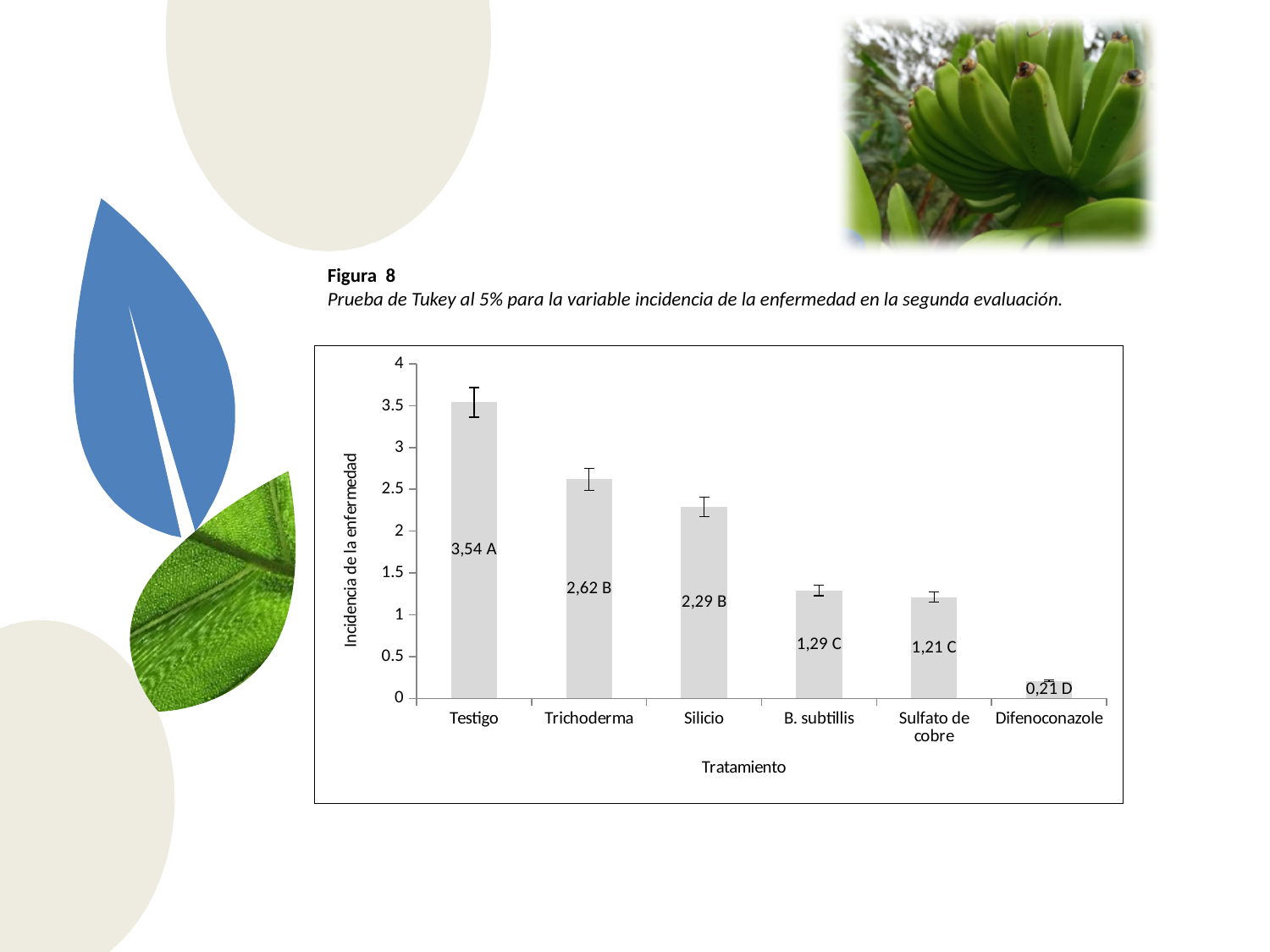
What is the label of the y axis? Incidencia de la enfermedad How many treatments are shown on the x axis? 6 Which has a larger value, Silicio or B. subtillis? Silicio Which treatment has the highest incidence of the disease? Testigo What is the difference between the values for Testigo and Difenoconazole? 3,33 What is the value shown for Sulfato de cobre? 1,21 C What is the value shown for Difenoconazole? 0,21 D What is the difference between the values for Trichoderma and Silicio? 0,33 What is the value shown for Trichoderma? 2,62 B What is the value shown for Testigo? 3,54 A What kind of chart is this? Bar chart Which treatment has the lowest incidence of the disease? Difenoconazole